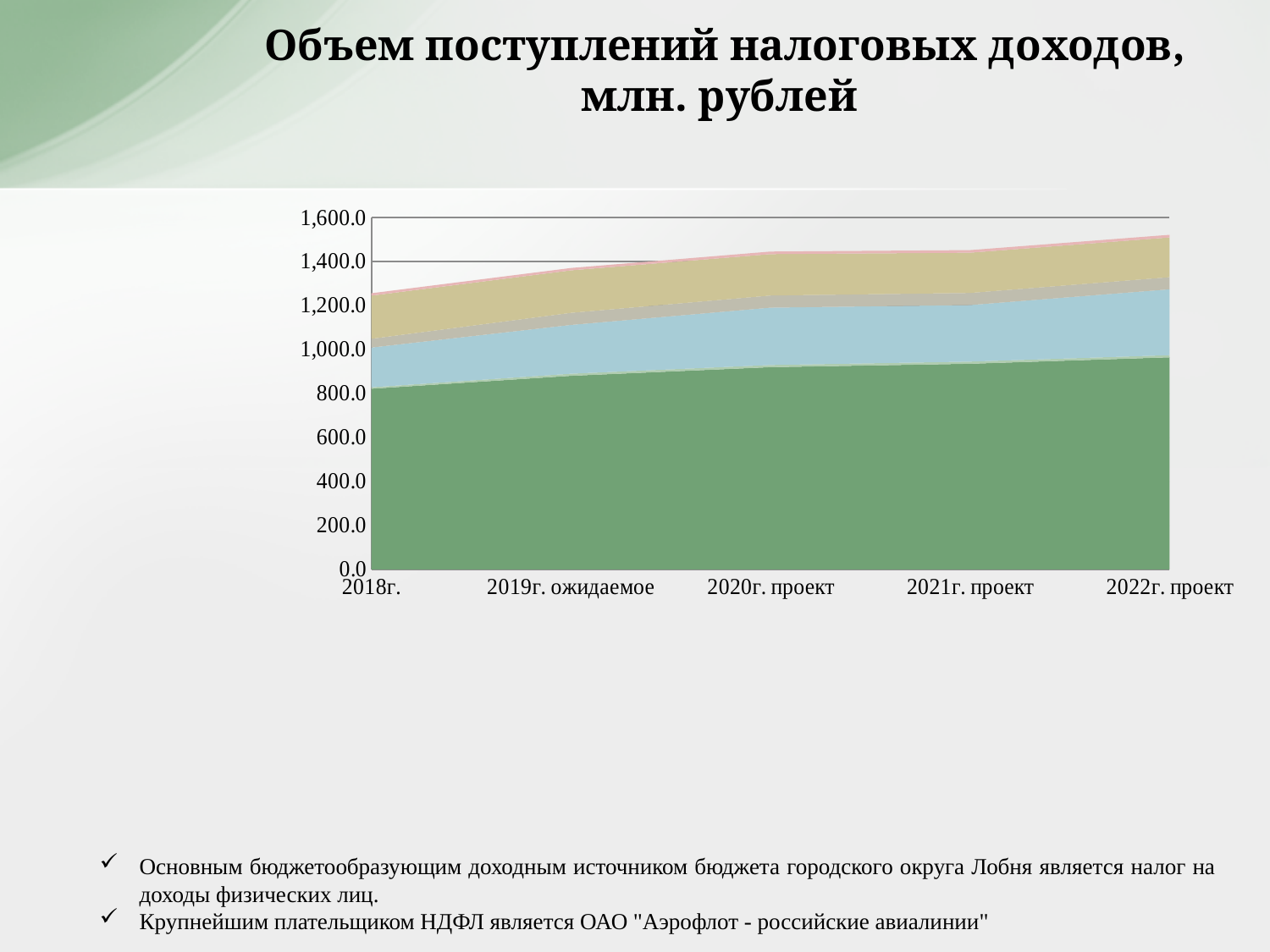
Is the total of the stacked areas for 2022г. проект greater or less than 1,400.0? greater Does the total height of the stacked areas rise or fall from 2018г. to 2022г. проект? Rises Is the total of the stacked areas for 2018г. greater or less than 1,400.0? less How many periods (categories) are shown along the x axis? 5 Is the total of the stacked areas for 2018г. greater or less than 1,200.0? greater In which period is the total of the stacked areas lowest? 2018г. Which is larger: the total of the stacked areas for 2022г. проект or for 2018г.? 2022г. проект In which period is the total of the stacked areas highest? 2022г. проект What is the title of the chart? Объем поступлений налоговых доходов, млн. рублей What kind of chart is shown on the slide? Stacked area chart What is the label of the first category on the x axis? 2018г.